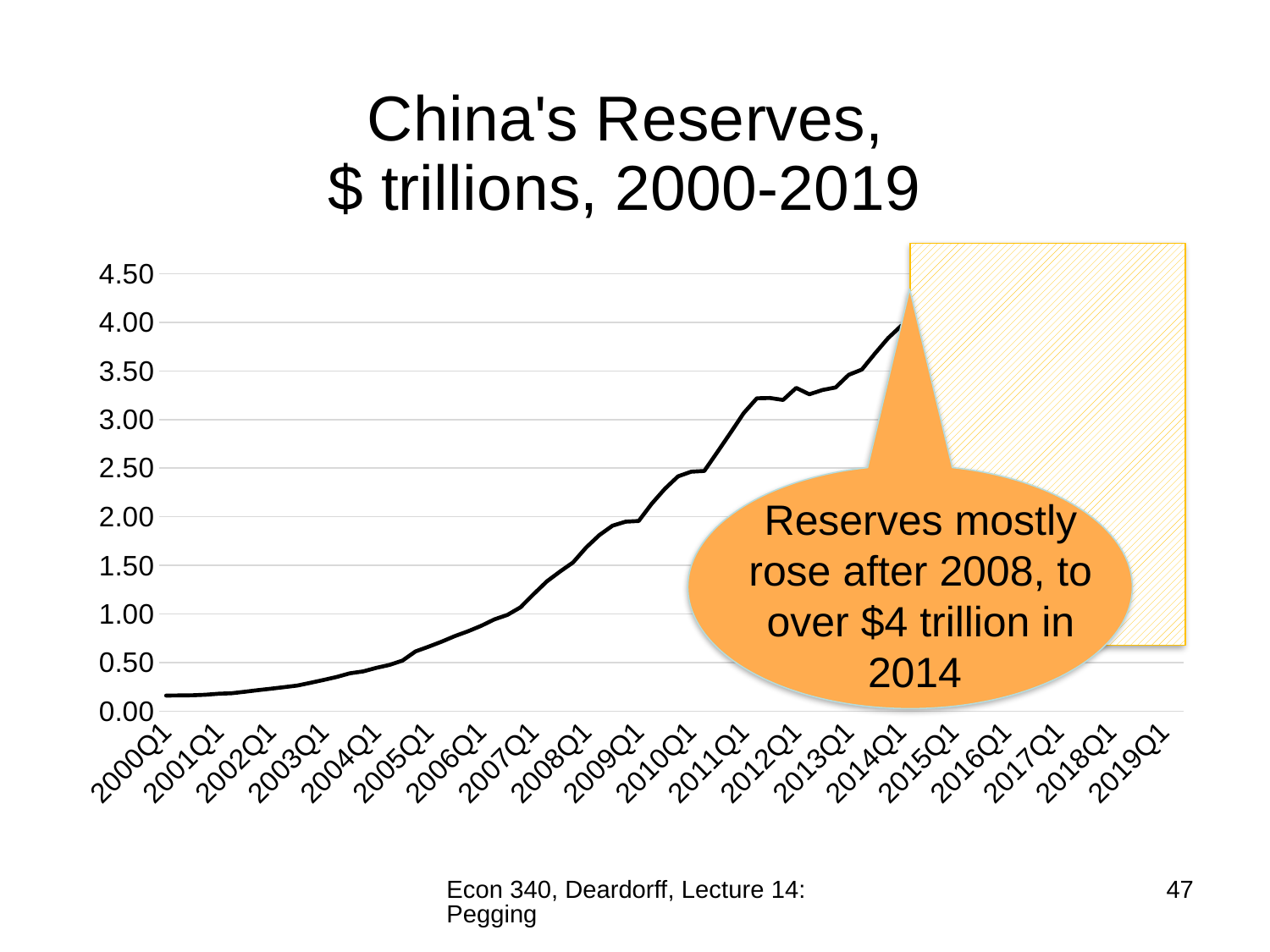
What kind of chart is shown on the slide? line chart What does the callout on the chart say? Reserves mostly rose after 2008, to over $4 trillion in 2014 How many year labels are shown on the x axis? 20 Is the value for 2000Q1 greater or less than 0.50? less Which is larger, the value for 2008Q1 or the value for 2013Q1? 2013Q1 Which is larger, the value for 2012Q1 or the value for 2004Q1? 2012Q1 Do China's reserves generally rise or fall from 2000Q1 to 2014Q1? rise Is the value for 2004Q1 greater or less than 1.00? less Is the value for 2012Q1 greater or less than 3.00? greater What is the title of the chart? China's Reserves, $ trillions, 2000-2019